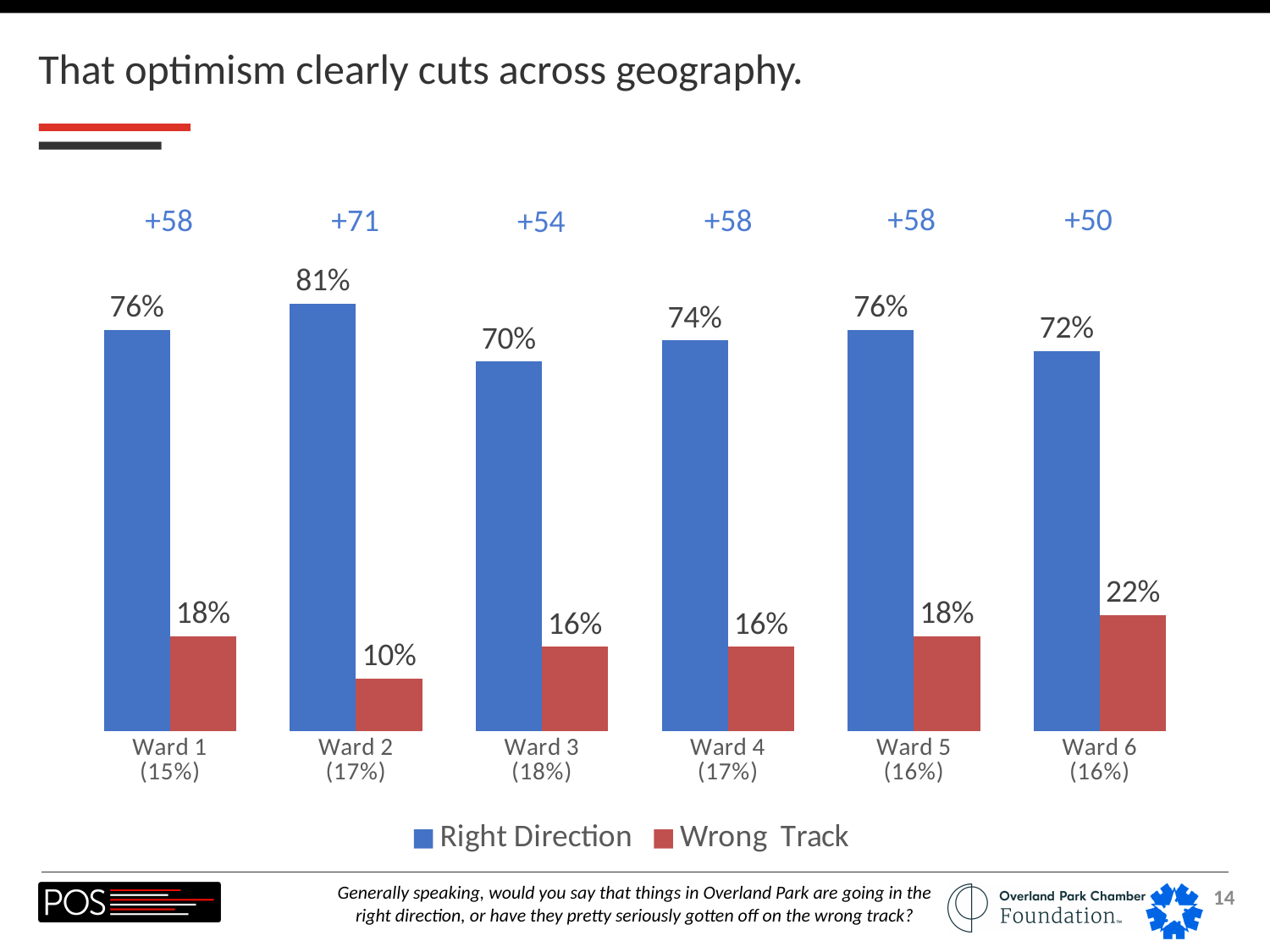
Which ward has the highest Right Direction value? Ward 2 How many series does the legend list? 2 What is the Wrong Track value for Ward 3? 16% Which is larger, the Wrong Track value for Ward 6 or for Ward 4? Ward 6 How many wards are shown on the x axis? 6 What is the Right Direction value for Ward 2? 81% Which ward has the lowest Wrong Track value? Ward 2 What is the Wrong Track value for Ward 6? 22% What is the difference between the Right Direction and Wrong Track values for Ward 1? 58 percentage points Which ward has the lowest Right Direction value? Ward 3 What kind of chart is shown on the slide? Bar chart What net figure is shown above the bars for Ward 6? +50